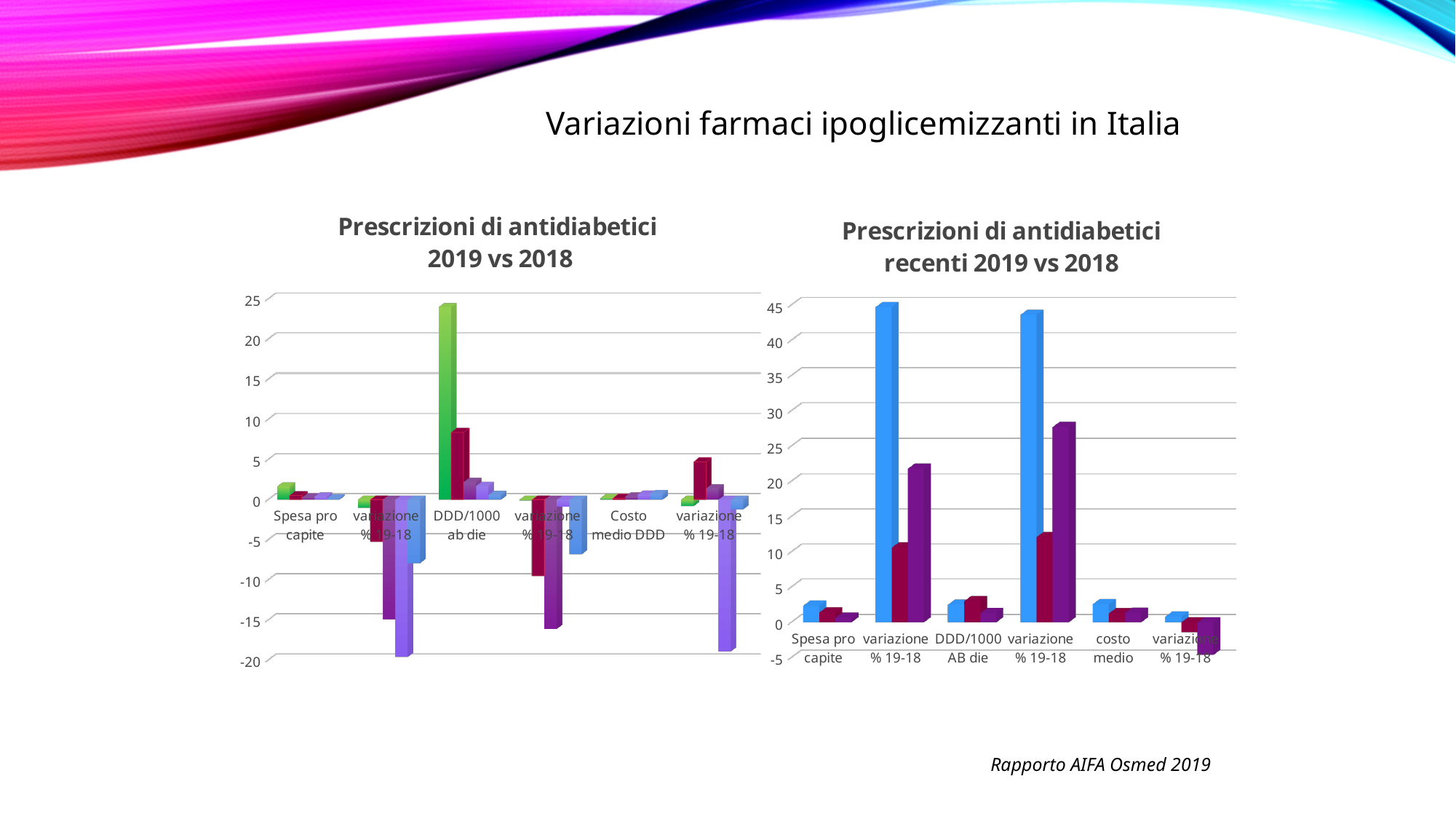
In the left chart "Prescrizioni di antidiabetici 2019 vs 2018", for DDD/1000 ab die, which bar is taller: the green bar or the dark red bar? The green bar What source is cited at the bottom right of the slide? Rapporto AIFA Osmed 2019 What kind of chart is the left chart titled "Prescrizioni di antidiabetici 2019 vs 2018"? Bar chart What kind of chart is the right chart titled "Prescrizioni di antidiabetici recenti 2019 vs 2018"? Bar chart How many categories are shown on the x axis of the left chart "Prescrizioni di antidiabetici 2019 vs 2018"? 6 In the right chart "Prescrizioni di antidiabetici recenti 2019 vs 2018", is the purple bar for the second "variazione % 19-18" category (after DDD/1000 AB die) greater or less than 25? greater In the left chart "Prescrizioni di antidiabetici 2019 vs 2018", which category contains the tallest bar? DDD/1000 ab die In the right chart "Prescrizioni di antidiabetici recenti 2019 vs 2018", is the purple bar larger in the first "variazione % 19-18" category or in the second "variazione % 19-18" category? The second "variazione % 19-18" category In the left chart "Prescrizioni di antidiabetici 2019 vs 2018", is the green bar for DDD/1000 ab die greater or less than 20? greater How many categories are shown on the x axis of the right chart "Prescrizioni di antidiabetici recenti 2019 vs 2018"? 6 In the right chart "Prescrizioni di antidiabetici recenti 2019 vs 2018", is the blue bar for the first "variazione % 19-18" category greater or less than 40? greater